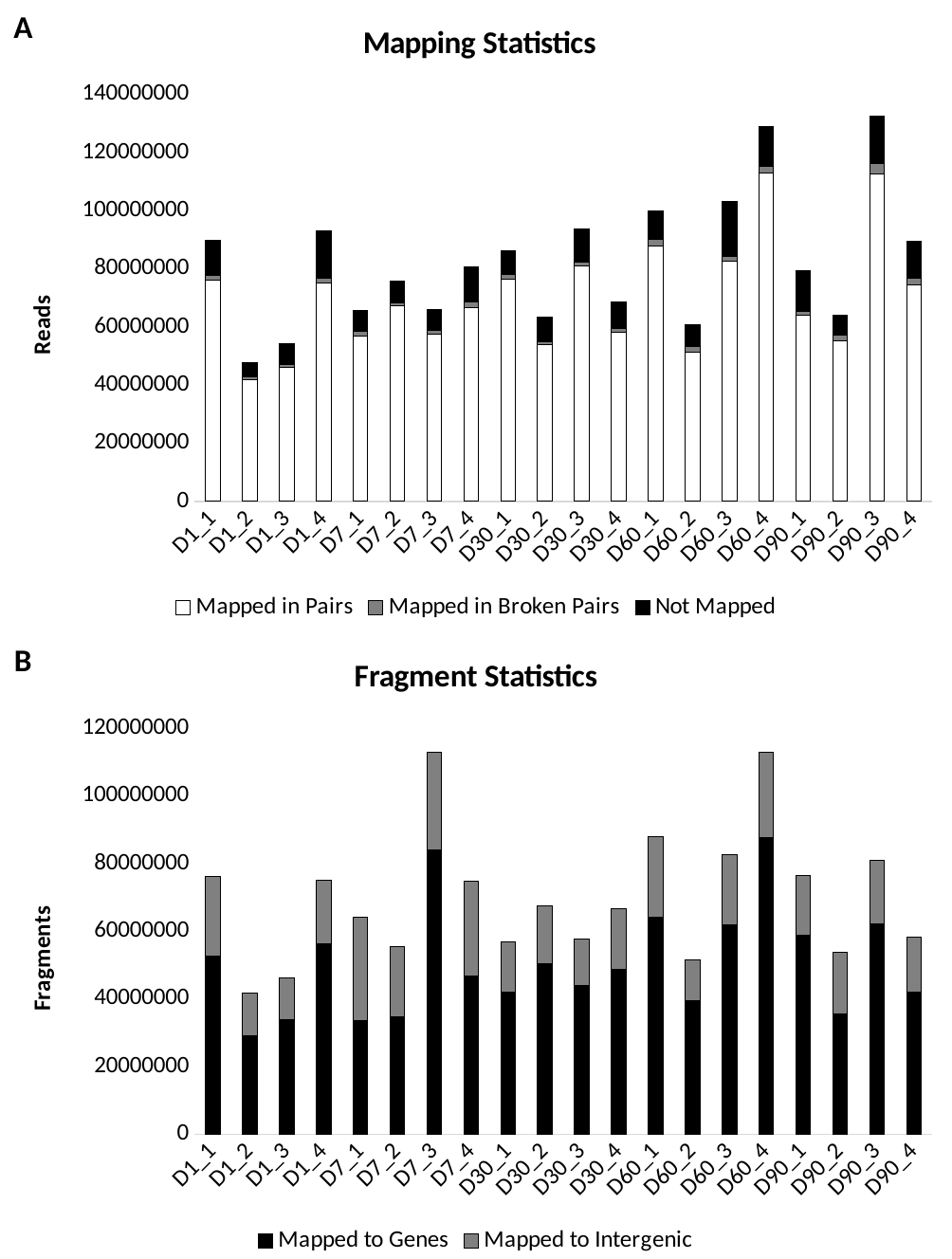
How many sample categories are shown on the x axis of the Mapping Statistics chart (panel A)? 20 What is the y-axis label of the Fragment Statistics chart (panel B)? Fragments In the Fragment Statistics chart (panel B), is the total fragments value for D60_1 greater or less than 80000000? greater How many series does the legend of the Fragment Statistics chart (panel B) list? 2 What type of chart is the Mapping Statistics chart (panel A)? stacked bar chart In the Mapping Statistics chart (panel A), which sample has the highest total reads? D90_3 In the Mapping Statistics chart (panel A), is the total reads value for D60_4 greater or less than 120000000? greater In the Fragment Statistics chart (panel B), which has the larger total fragments, D60_2 or D60_3? D60_3 In the Fragment Statistics chart (panel B), which sample has the lowest total fragments? D1_2 In the Mapping Statistics chart (panel A), is the total reads value for D1_2 greater or less than 60000000? less In the Mapping Statistics chart (panel A), which sample has the lowest total reads? D1_2 How many series does the legend of the Mapping Statistics chart (panel A) list? 3